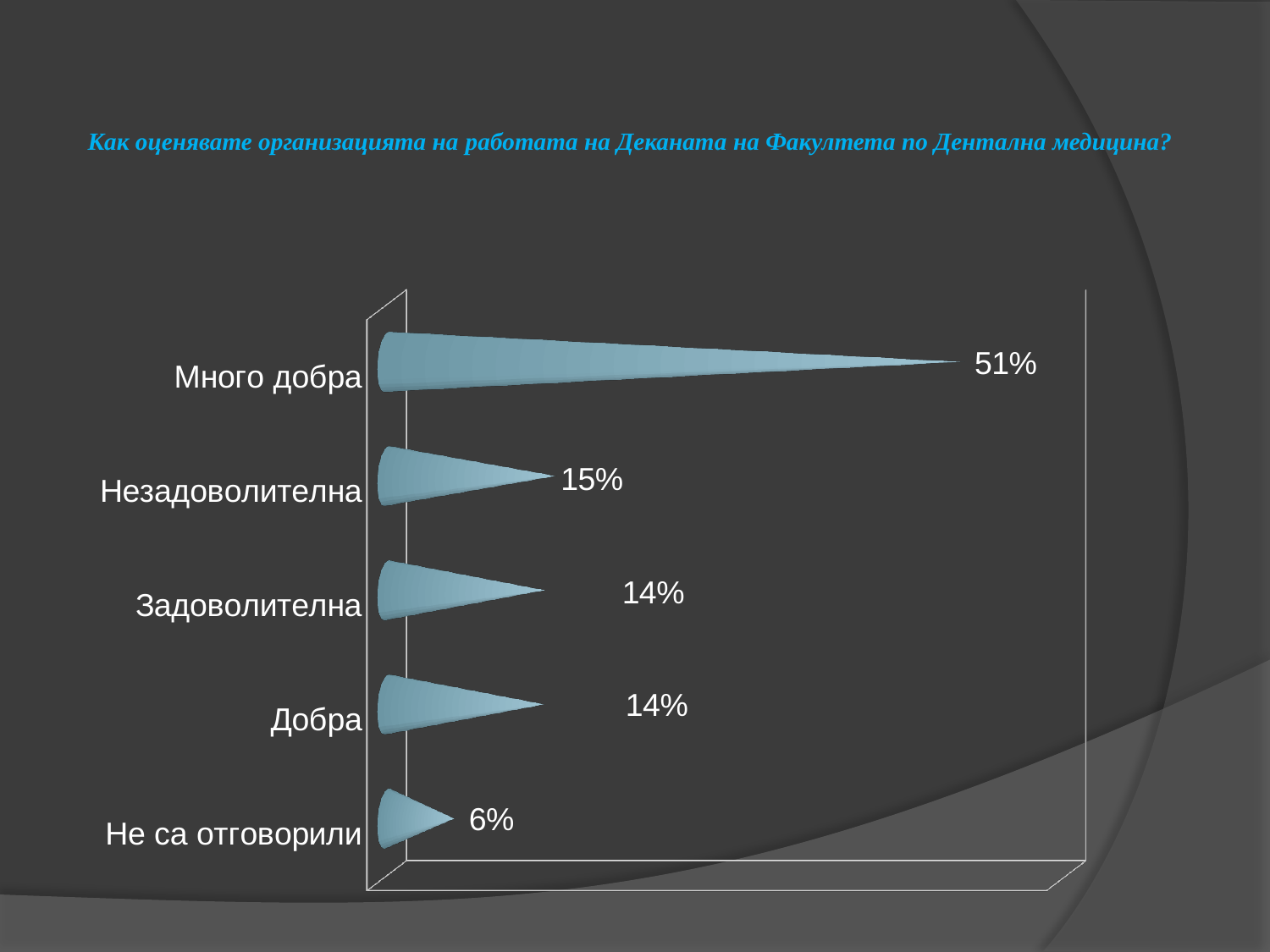
What is the value for Не са отговорили? 6% What is the difference between the values for Добра and Не са отговорили? 8% Which category has the lowest value? Не са отговорили What is the value for Много добра? 51% Which category has the highest value? Много добра Which is larger, the value for Много добра or the value for Добра? Много добра What is the value for Задоволителна? 14% What is the difference between the values for Много добра and Незадоволителна? 36% What is the value for Незадоволителна? 15% How many categories are shown in the chart? 5 What kind of chart is shown on the slide? Bar chart What is the title of the chart? Как оценявате организацията на работата на Деканата на Факултета по Дентална медицина?